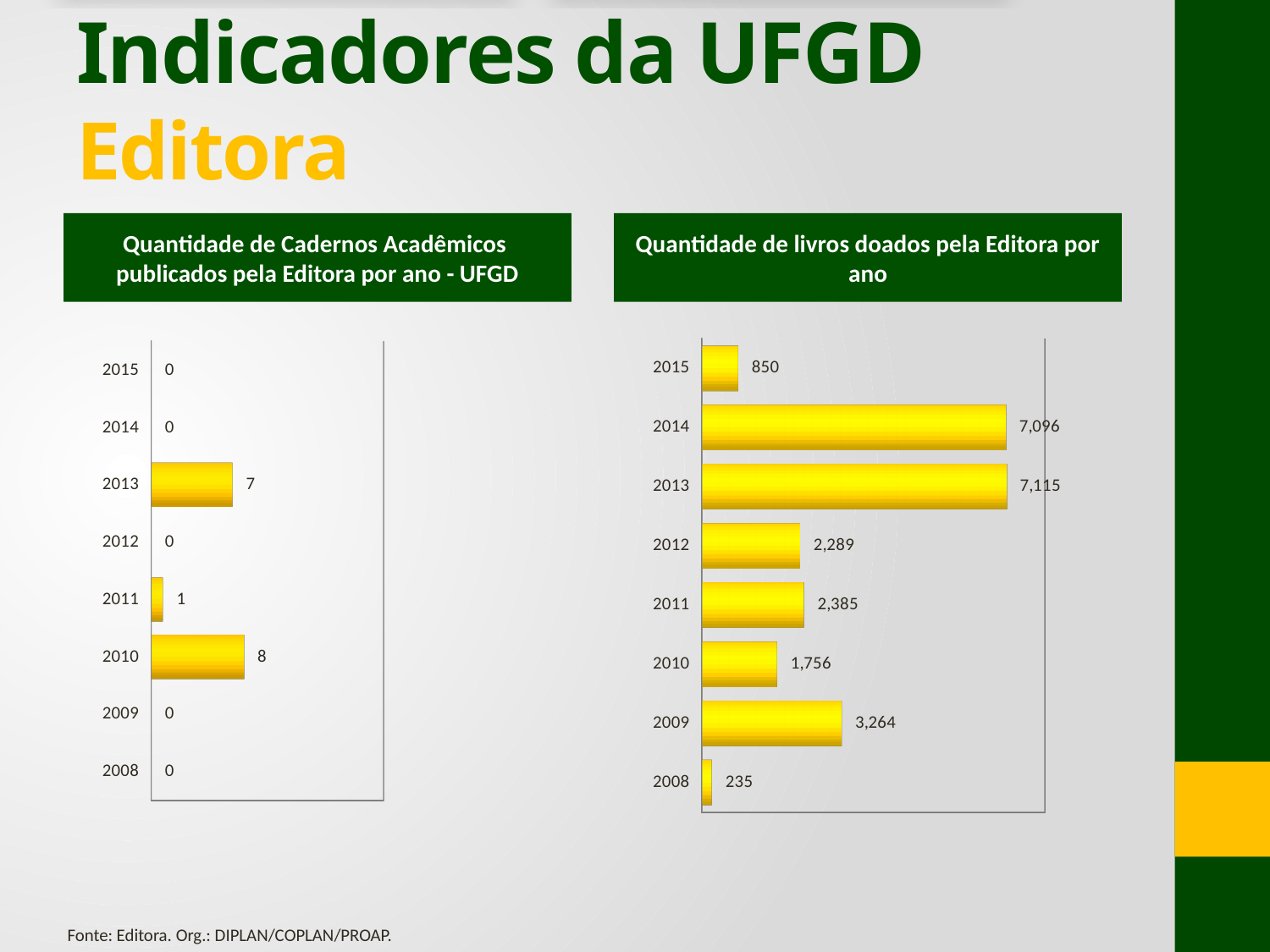
In the chart 'Quantidade de livros doados pela Editora por ano', which is larger, the value for 2011 or the value for 2010? 2011 In the chart 'Quantidade de Cadernos Acadêmicos publicados pela Editora por ano - UFGD', what is the value for 2013? 7 In the chart 'Quantidade de livros doados pela Editora por ano', what is the difference between the values for 2013 and 2014? 19 What colour are the bars in the chart 'Quantidade de Cadernos Acadêmicos publicados pela Editora por ano - UFGD'? Yellow In the chart 'Quantidade de livros doados pela Editora por ano', which year has the highest value? 2013 In the chart 'Quantidade de livros doados pela Editora por ano', which year has the lowest value? 2008 In the chart 'Quantidade de Cadernos Acadêmicos publicados pela Editora por ano - UFGD', which year has the highest value? 2010 In the chart 'Quantidade de livros doados pela Editora por ano', what is the value for 2009? 3,264 In the chart 'Quantidade de Cadernos Acadêmicos publicados pela Editora por ano - UFGD', what is the difference between the values for 2010 and 2013? 1 In the chart 'Quantidade de Cadernos Acadêmicos publicados pela Editora por ano - UFGD', how many years are shown? 8 What kind of chart is 'Quantidade de livros doados pela Editora por ano'? Bar chart In the chart 'Quantidade de livros doados pela Editora por ano', what is the value for 2015? 850